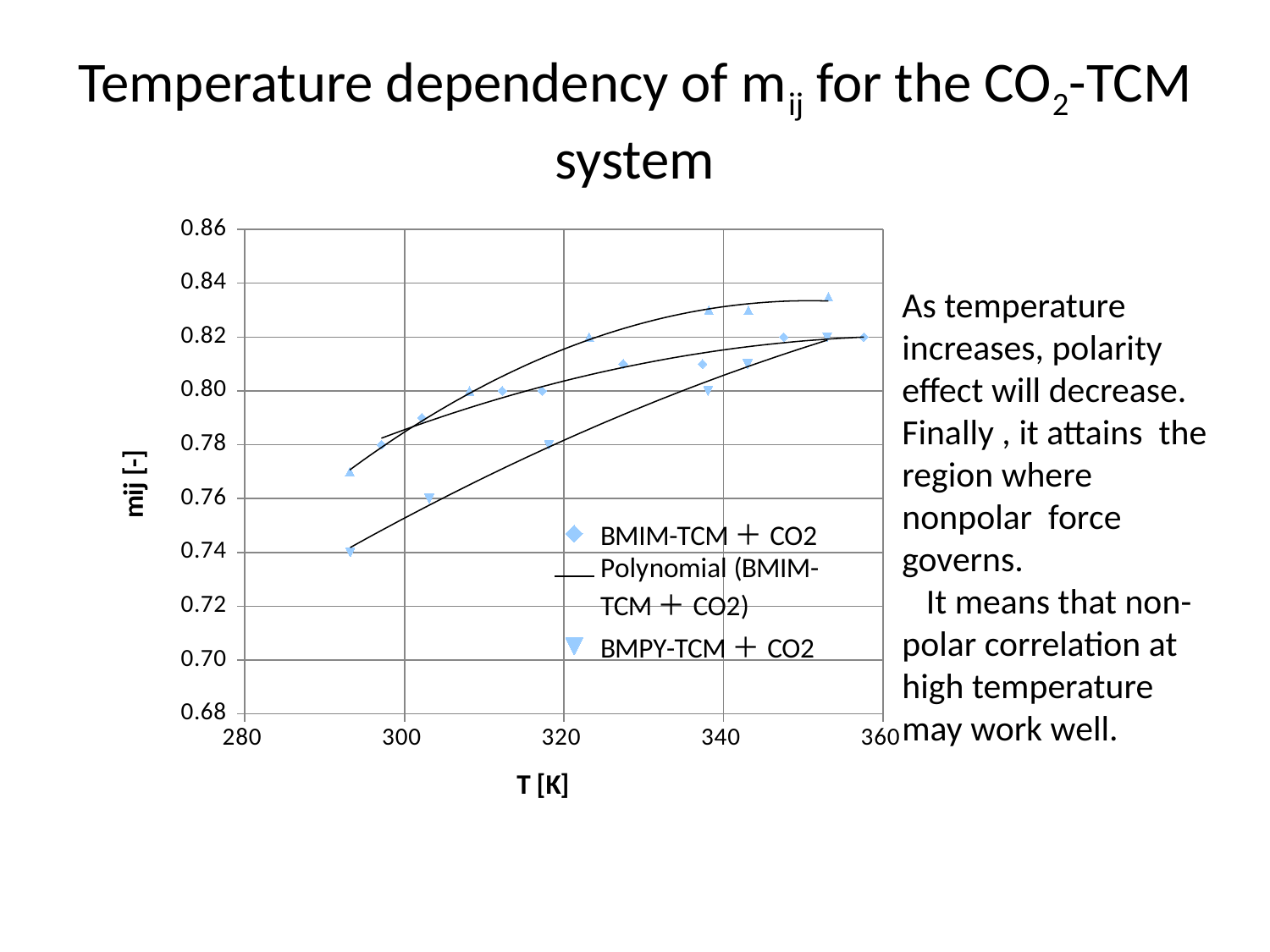
Do the mij values rise or fall as temperature increases along the x axis? rise What is the title of the y axis of the chart? mij [-] How many entries does the chart legend list? 3 What kind of chart is shown on the slide? scatter chart Is the lowest BMPY-TCM + CO2 value greater or less than 0.76? less What is the title of the x axis of the chart? T [K] Is the highest BMIM-TCM + CO2 value greater or less than 0.84? less Is the BMPY-TCM + CO2 value at about 343 K greater or less than 0.80? greater At about 303 K, which series has the higher mij value, BMIM-TCM + CO2 or BMPY-TCM + CO2? BMIM-TCM + CO2 Which legend series contains the lowest mij value plotted on the chart? BMPY-TCM + CO2